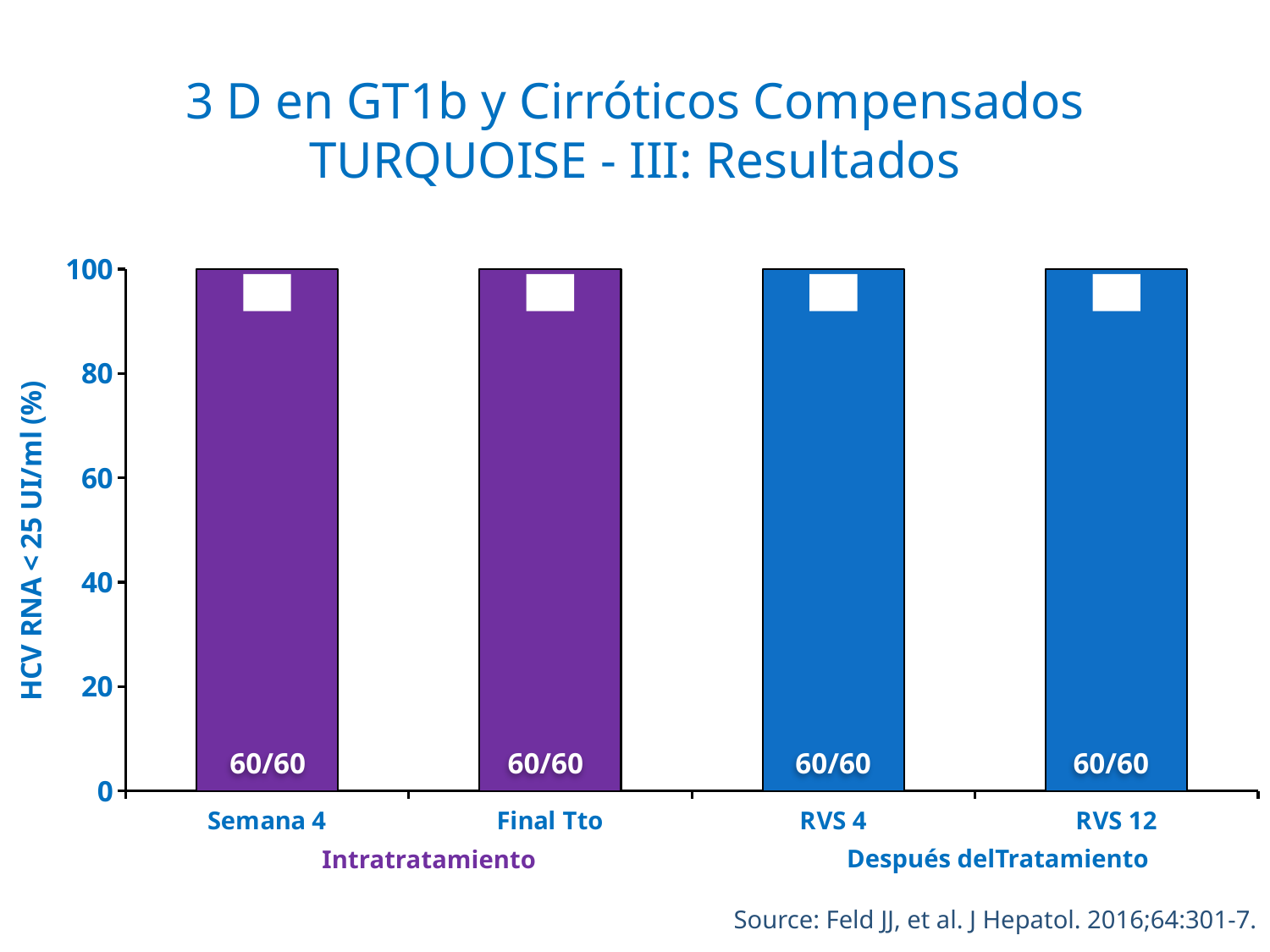
Is the value for RVS 4 greater or less than 80? greater What percentage value does the bar for RVS 4 reach on the y axis? 100 What is the label of the y axis? HCV RNA < 25 UI/ml (%) How many bars are plotted in the chart? 4 Do the values rise, fall or stay flat from Semana 4 to RVS 12? stay flat What is the data label printed on the bar for RVS 12? 60/60 Is the value for Semana 4 greater or less than 60? greater Which group label appears under the bars for RVS 4 and RVS 12? Después delTratamiento What is the data label printed on the bar for Semana 4? 60/60 What percentage value does the bar for Final Tto reach on the y axis? 100 What kind of chart is shown on the slide? bar chart